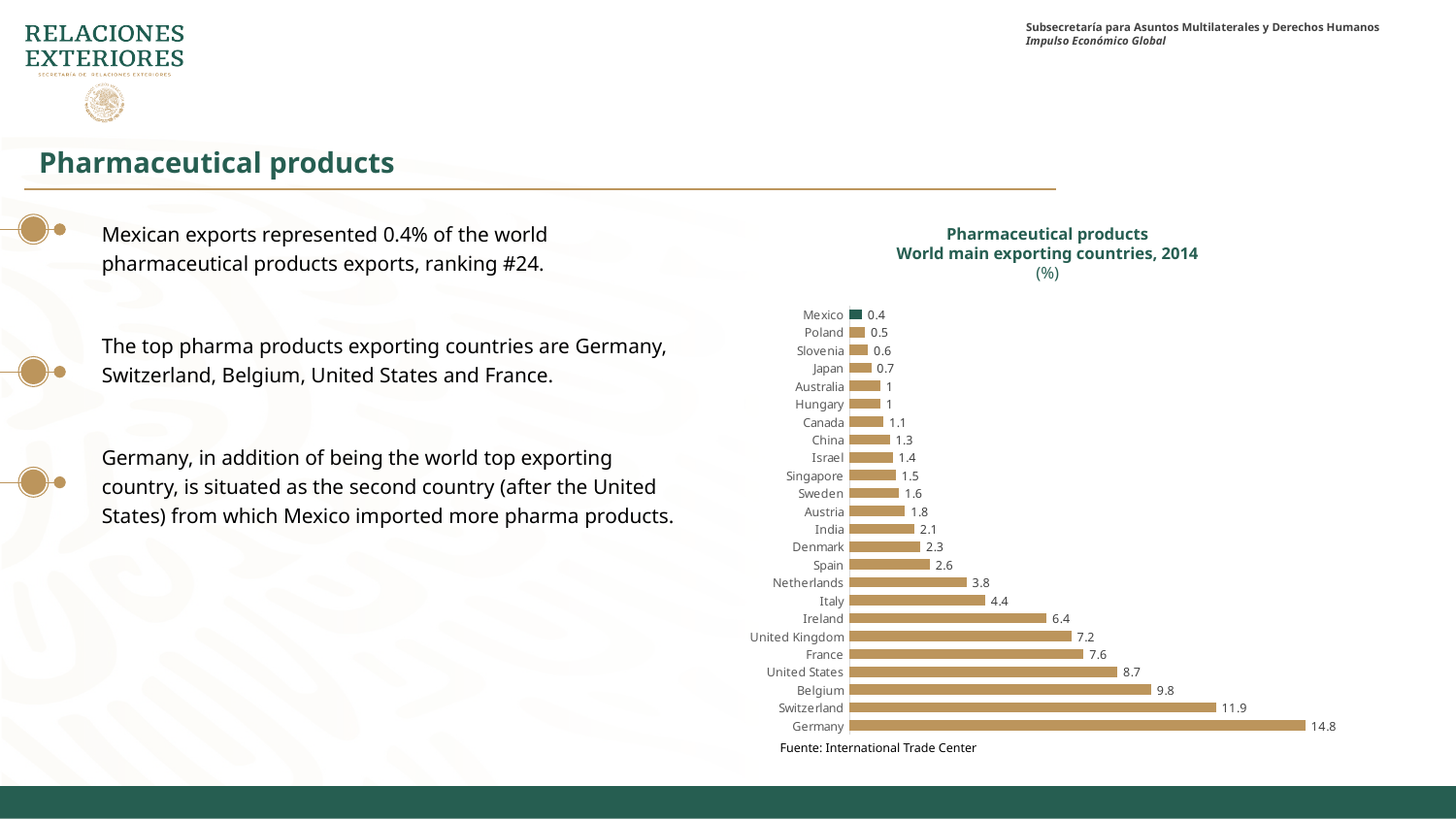
What is the title of the chart? Pharmaceutical products World main exporting countries, 2014 What is the value for Netherlands? 3.8 What is the value for Mexico? 0.4 How many countries are shown in the chart? 24 What is the difference between the values for Belgium and the United States? 1.1 Which country has the highest value? Germany Which country has the lowest value? Mexico What is the value for the United Kingdom? 7.2 Which is larger, the value for France or the value for Ireland? France What kind of chart is shown on the slide? Bar chart What is the value for Germany? 14.8 What is the difference between the values for Germany and Switzerland? 2.9